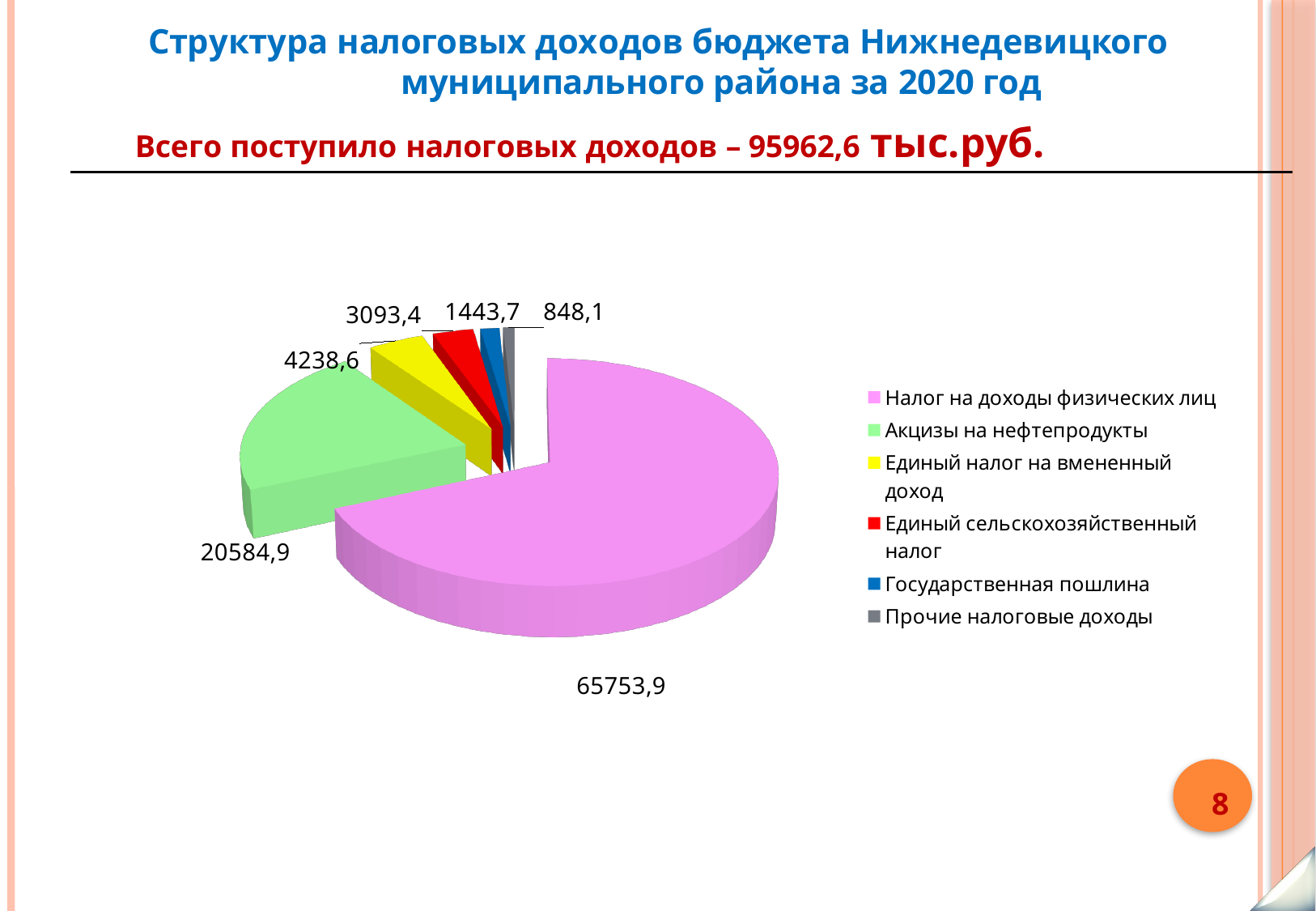
What is the value for Налог на доходы физических лиц? 65753,9 What colour is the slice for Акцизы на нефтепродукты? green Which category has the smallest slice of the pie? Прочие налоговые доходы Which category has the largest slice of the pie? Налог на доходы физических лиц What is the difference between the values for Единый налог на вмененный доход and Единый сельскохозяйственный налог? 1145,2 How many categories does the legend list? 6 What is the value for Акцизы на нефтепродукты? 20584,9 Which is larger: the value for Единый сельскохозяйственный налог or the value for Государственная пошлина? Единый сельскохозяйственный налог What is the difference between the values for Налог на доходы физических лиц and Акцизы на нефтепродукты? 45169,0 What type of chart is shown on the slide? pie chart What is the value for Государственная пошлина? 1443,7 What is the value for Единый налог на вмененный доход? 4238,6